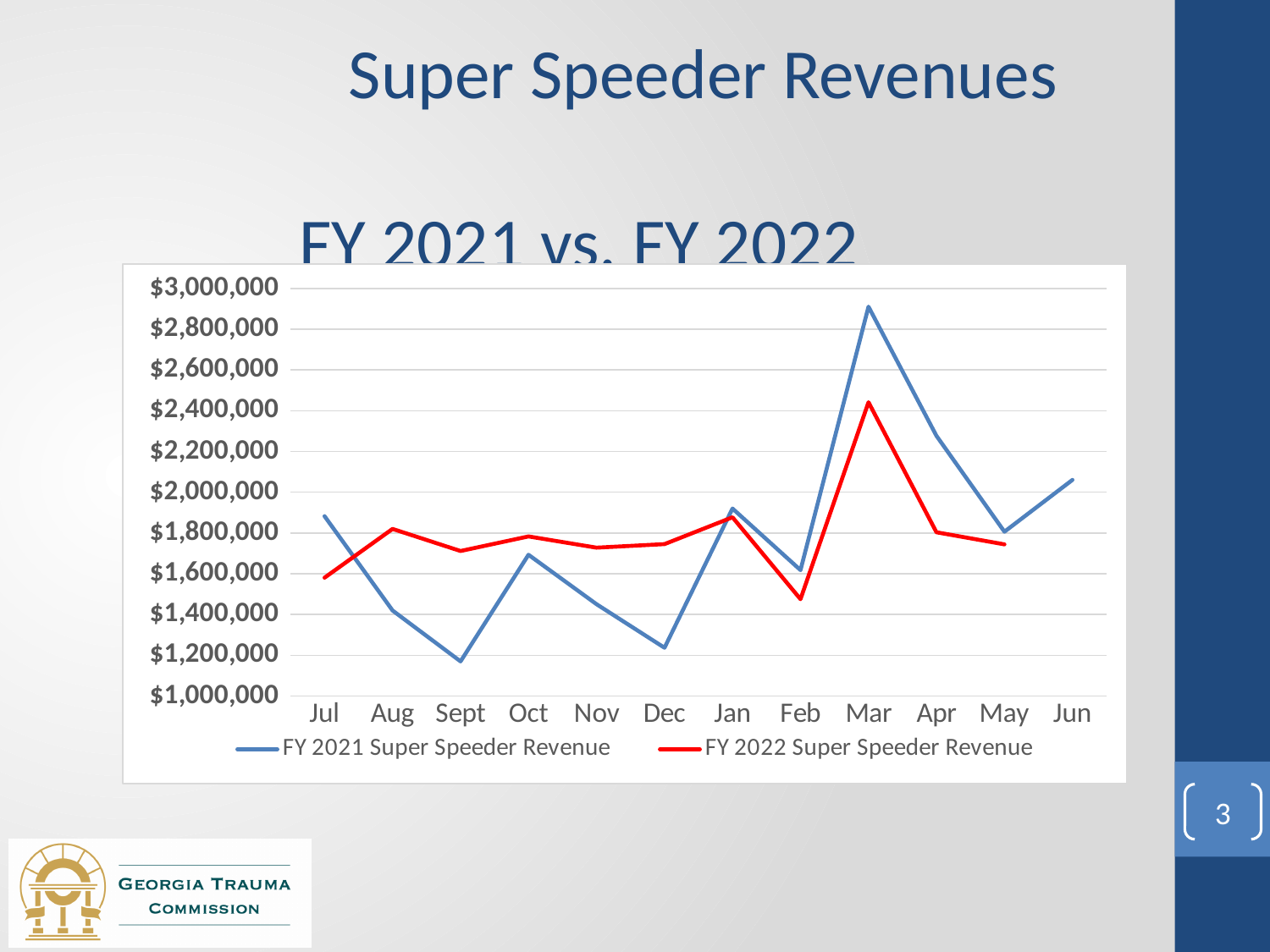
Is the FY 2022 Super Speeder Revenue for Feb greater or less than $1,600,000? less Is the FY 2021 Super Speeder Revenue for Mar greater or less than $2,800,000? greater In which month is FY 2021 Super Speeder Revenue highest? Mar In which month is FY 2022 Super Speeder Revenue highest? Mar How many months are shown on the x axis? 12 What colour is the FY 2022 Super Speeder Revenue line? Red In which month is FY 2022 Super Speeder Revenue lowest? Feb Does FY 2021 Super Speeder Revenue rise or fall from Jul to Sept? Fall What kind of chart is shown on the slide? Line chart In which month is FY 2021 Super Speeder Revenue lowest? Sept Which series has the higher value in Aug, FY 2021 Super Speeder Revenue or FY 2022 Super Speeder Revenue? FY 2022 Super Speeder Revenue How many series does the legend list? 2